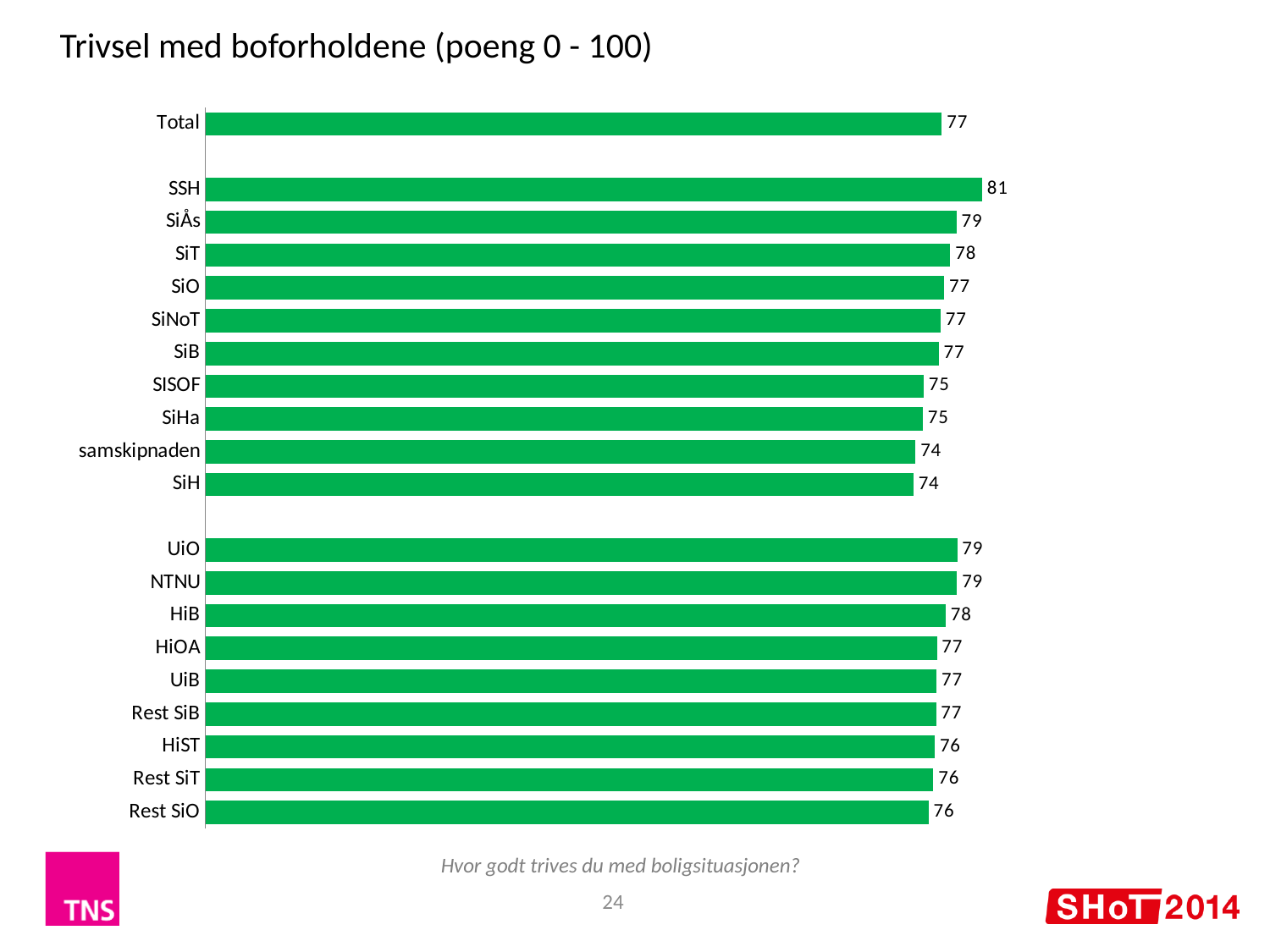
What is the title of the chart? Trivsel med boforholdene (poeng 0 - 100) Which has a larger value, SiÅs or HiST? SiÅs Which category has the highest value? SSH What is the value for SSH? 81 What kind of chart is shown on the slide? Bar chart What is the lowest value shown on the chart? 74 What is the value for samskipnaden? 74 What is the value for Rest SiO? 76 What is the value for Total? 77 What colour are the bars in the chart? Green How many bars are shown on the chart? 20 What is the difference between the values for SSH and SiH? 7